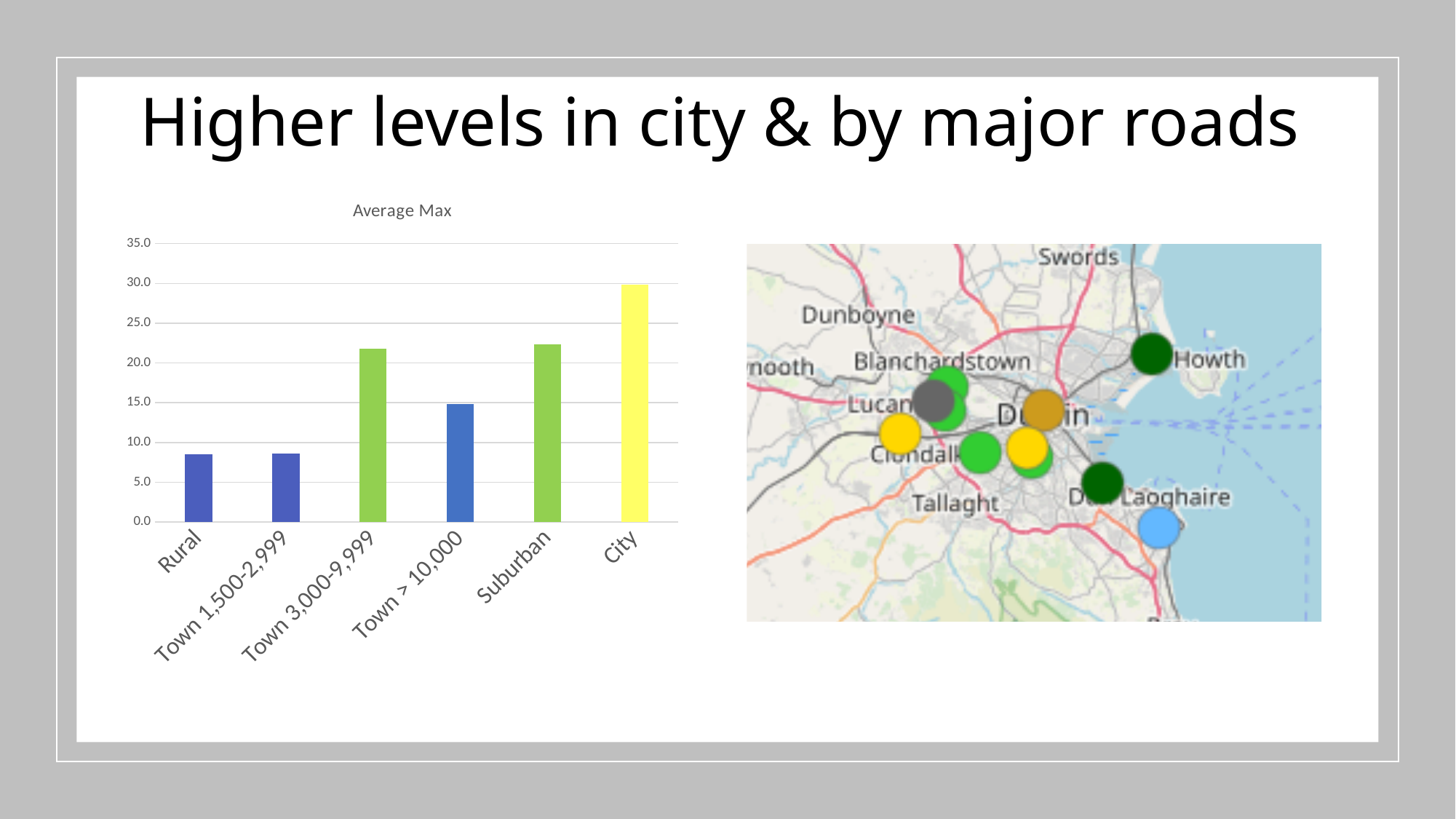
What is the title of the chart? Average Max What kind of chart is shown on the slide? bar chart Which category has the highest value in the chart? City What colour is the bar for City? yellow Is the value for City greater or less than 25? greater Which is larger, the value for City or the value for Suburban? City Is the value for Rural greater or less than 10? less Is the value for Suburban greater or less than 20? greater Which is larger, the value for Town 3,000-9,999 or the value for Town > 10,000? Town 3,000-9,999 How many categories are shown on the x axis of the chart? 6